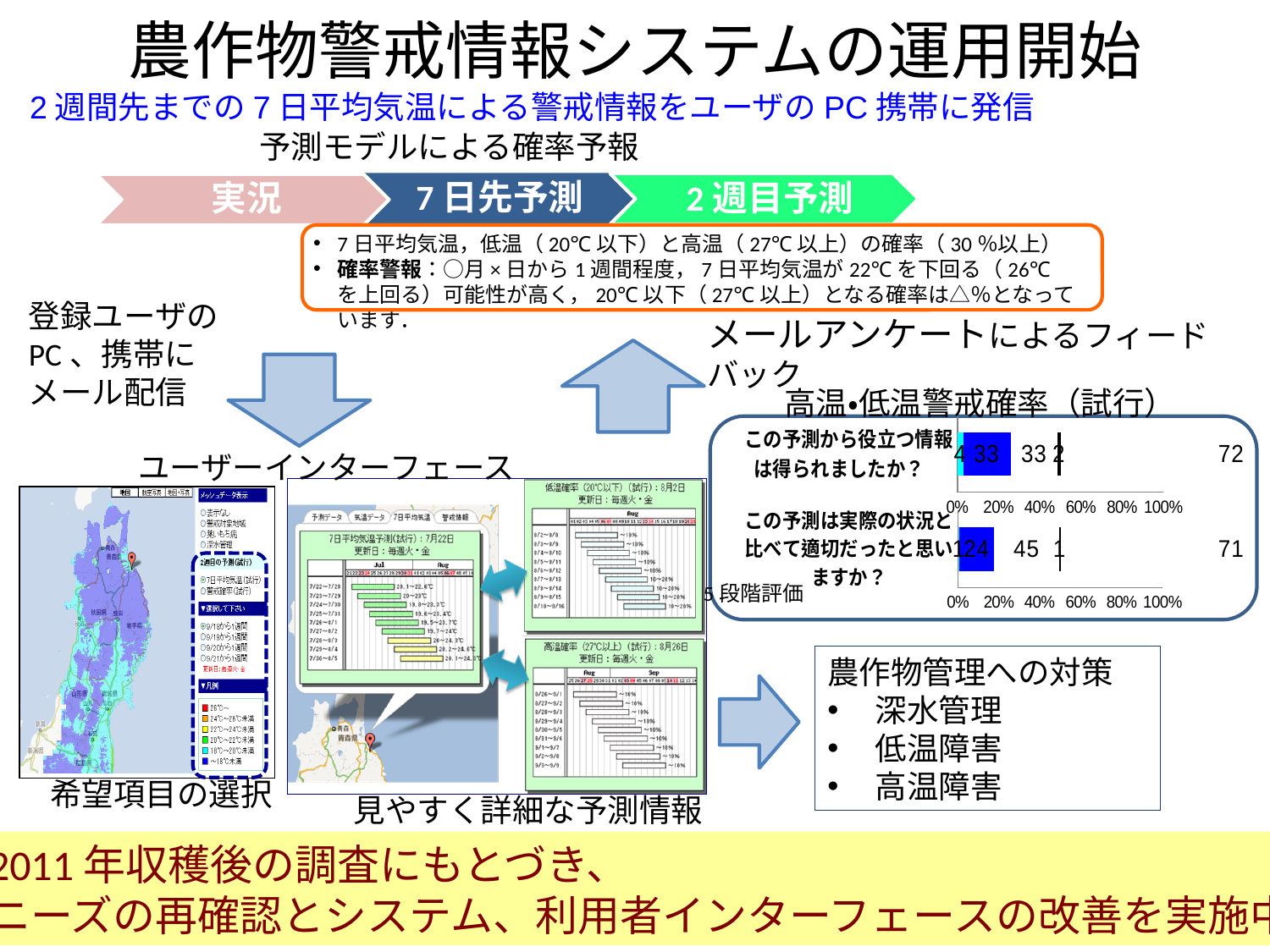
How many bar charts are shown inside the survey box titled 高温•低温警戒確率（試行）? 2 In the upper survey chart, is the value 33 larger or smaller than the value 4? larger What is the title written above the survey box containing the two bar charts? 高温•低温警戒確率（試行） In the lower survey chart (この予測は実際の状況と比べて適切だったと思いますか？), what number is printed at the far right end of the bar? 71 In the lower survey chart (この予測は実際の状況と比べて適切だったと思いますか？), what is the largest segment value printed on the bar? 45 In the survey charts, what is the highest value shown on the horizontal axis? 100% In the upper survey chart (この予測から役立つ情報は得られましたか？), what number is printed at the far right end of the bar? 72 In the survey charts, what is the lowest value shown on the horizontal axis? 0% In the upper survey chart (この予測から役立つ情報は得られましたか？), what is the smallest segment value printed on the bar? 2 What is the difference between the numbers printed at the right end of the upper survey bar (72) and the lower survey bar (71)? 1 Which survey chart has the larger number printed at the right end of its bar, the upper one (72) or the lower one (71)? the upper one What kind of chart is used in the survey box titled 高温•低温警戒確率（試行）? bar chart